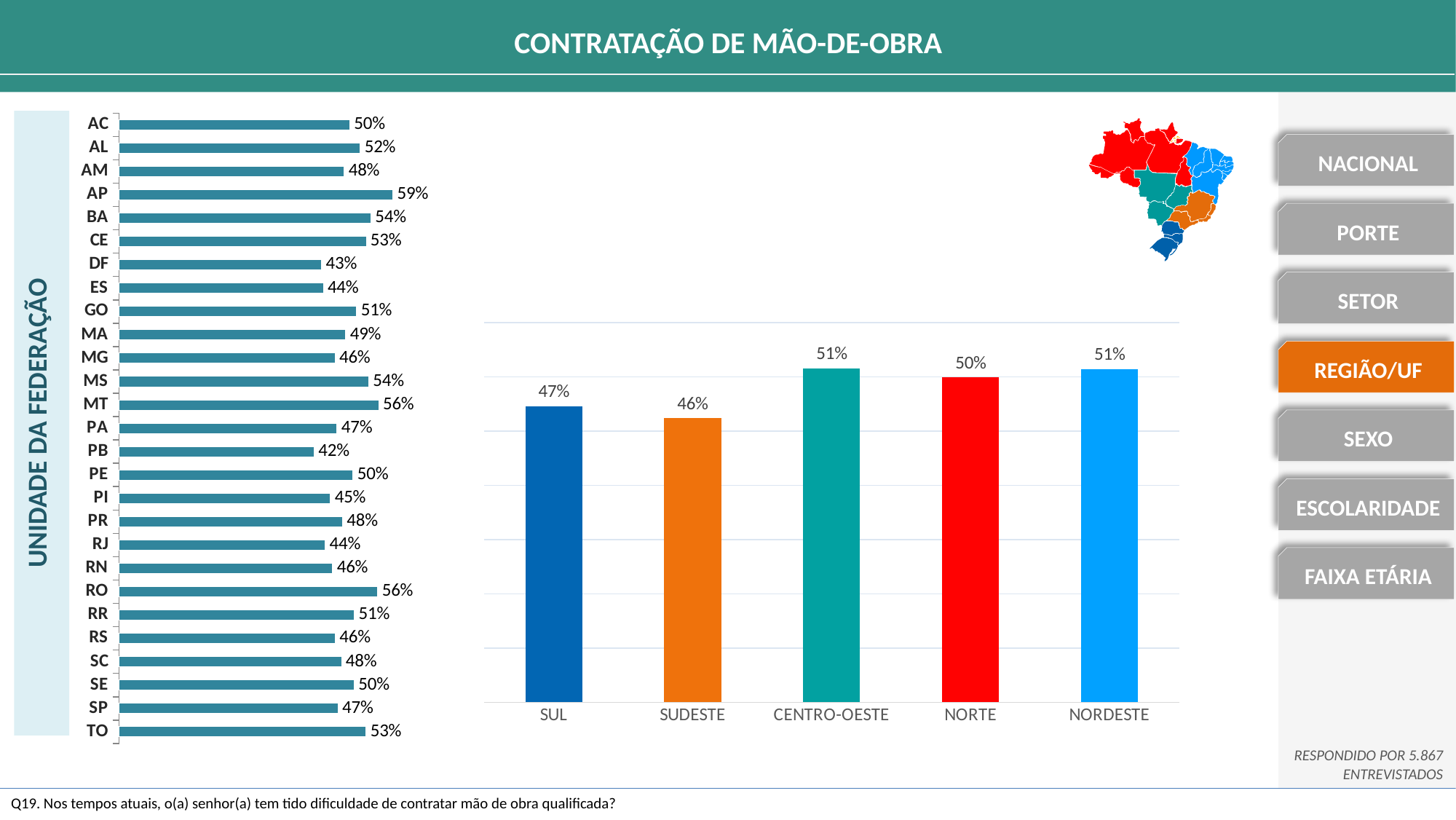
In the chart by unidade da federação on the left, what is the value for AP? 59% In the chart by unidade da federação on the left, which state has the highest value? AP In the region chart on the right, what is the difference between the values for NORDESTE and SUL? 4% In the chart by unidade da federação on the left, which has a larger value, BA or DF? BA What type of chart is the region chart on the right? Bar chart In the chart by unidade da federação on the left, what is the value for MT? 56% How many states are listed in the chart by unidade da federação on the left? 27 In the region chart on the right, what is the value for NORTE? 50% In the region chart on the right, which region has the lowest value? SUDESTE In the chart by unidade da federação on the left, which state has the lowest value? PB In the region chart on the right, what is the value for SUDESTE? 46% In the chart by unidade da federação on the left, what is the difference between the values for AP and PB? 17%